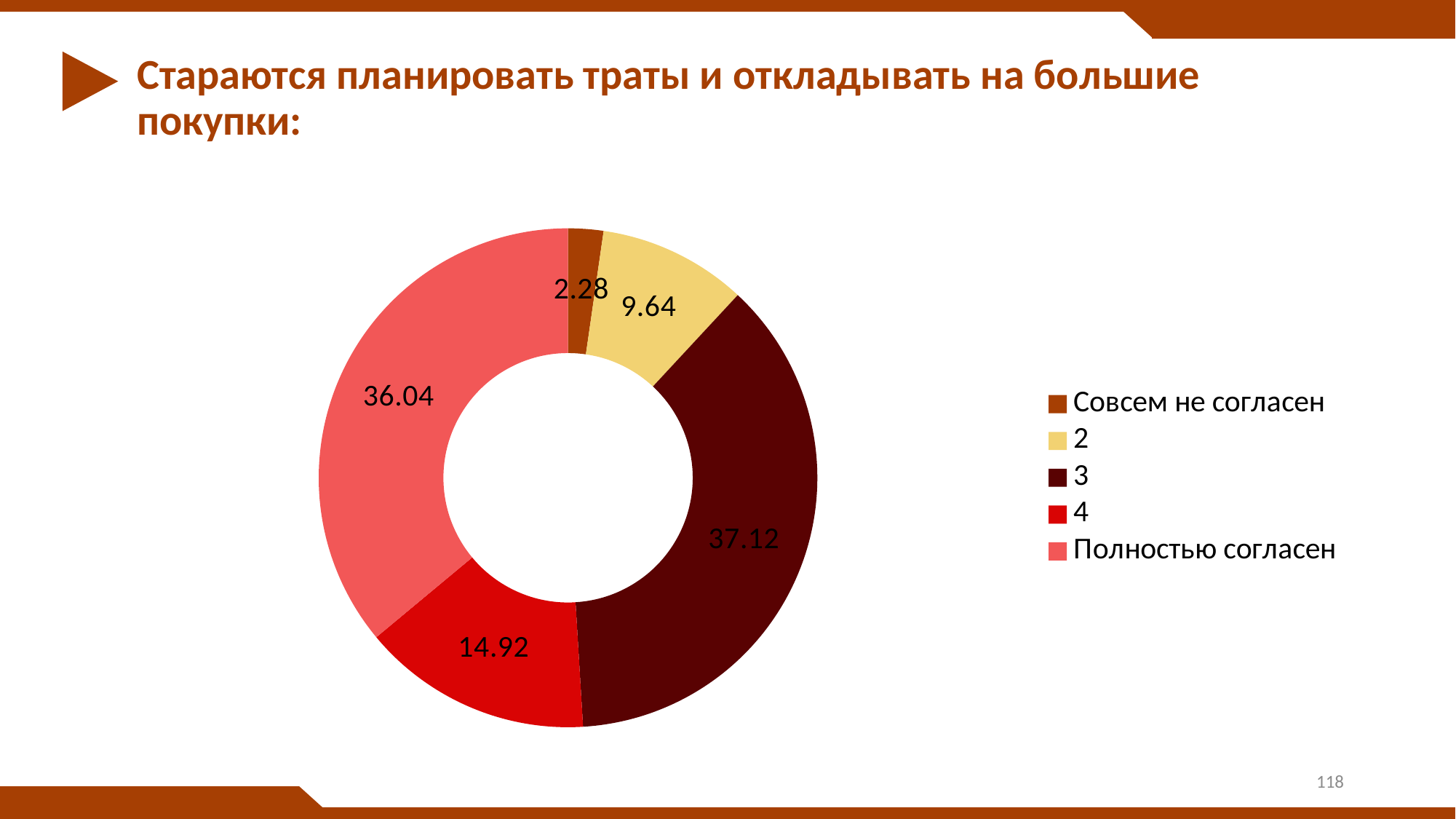
Which legend entry is shown in the light yellow colour? 2 What is the value for the category "Полностью согласен"? 36.04 What is the value for the category "Совсем не согласен"? 2.28 What is the value for category "3"? 37.12 Which category has the smallest value? Совсем не согласен What is the difference between the values for category "3" and "Полностью согласен"? 1.08 Which category has the largest value? 3 Which is larger: the value for category "4" or for category "2"? 4 What is the value for category "4"? 14.92 What is the value for category "2"? 9.64 How many categories does the chart show? 5 What type of chart is shown on the slide? Doughnut chart